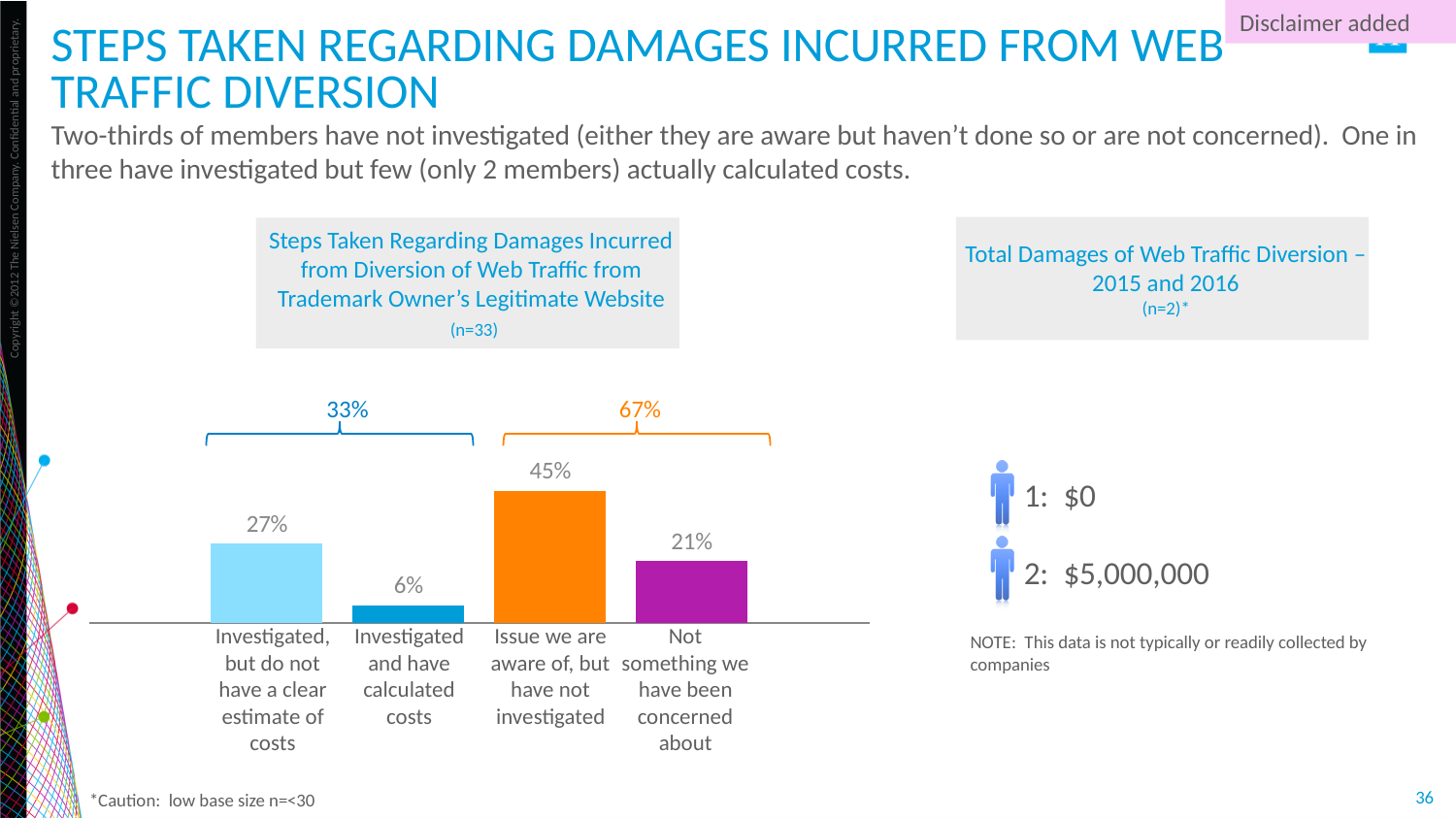
Which category has the highest percentage in the bar chart? Issue we are aware of, but have not investigated What percentage of members investigated and have calculated costs? 6% What percentage of members said the issue is one they are aware of but have not investigated? 45% What type of chart is used to show the steps taken regarding damages? Bar chart How many categories are shown in the bar chart? 4 What combined percentage is shown by the bracket over the two 'Investigated' bars? 33% What percentage of members investigated but do not have a clear estimate of costs? 27% What is the difference in percentage points between 'Issue we are aware of, but have not investigated' and 'Not something we have been concerned about'? 24 percentage points What percentage of members said it is not something they have been concerned about? 21% What is the sample size (n) shown in the bar chart's title? n=33 Which is larger: the percentage for 'Investigated, but do not have a clear estimate of costs' or for 'Not something we have been concerned about'? Investigated, but do not have a clear estimate of costs Which category has the lowest percentage in the bar chart? Investigated and have calculated costs